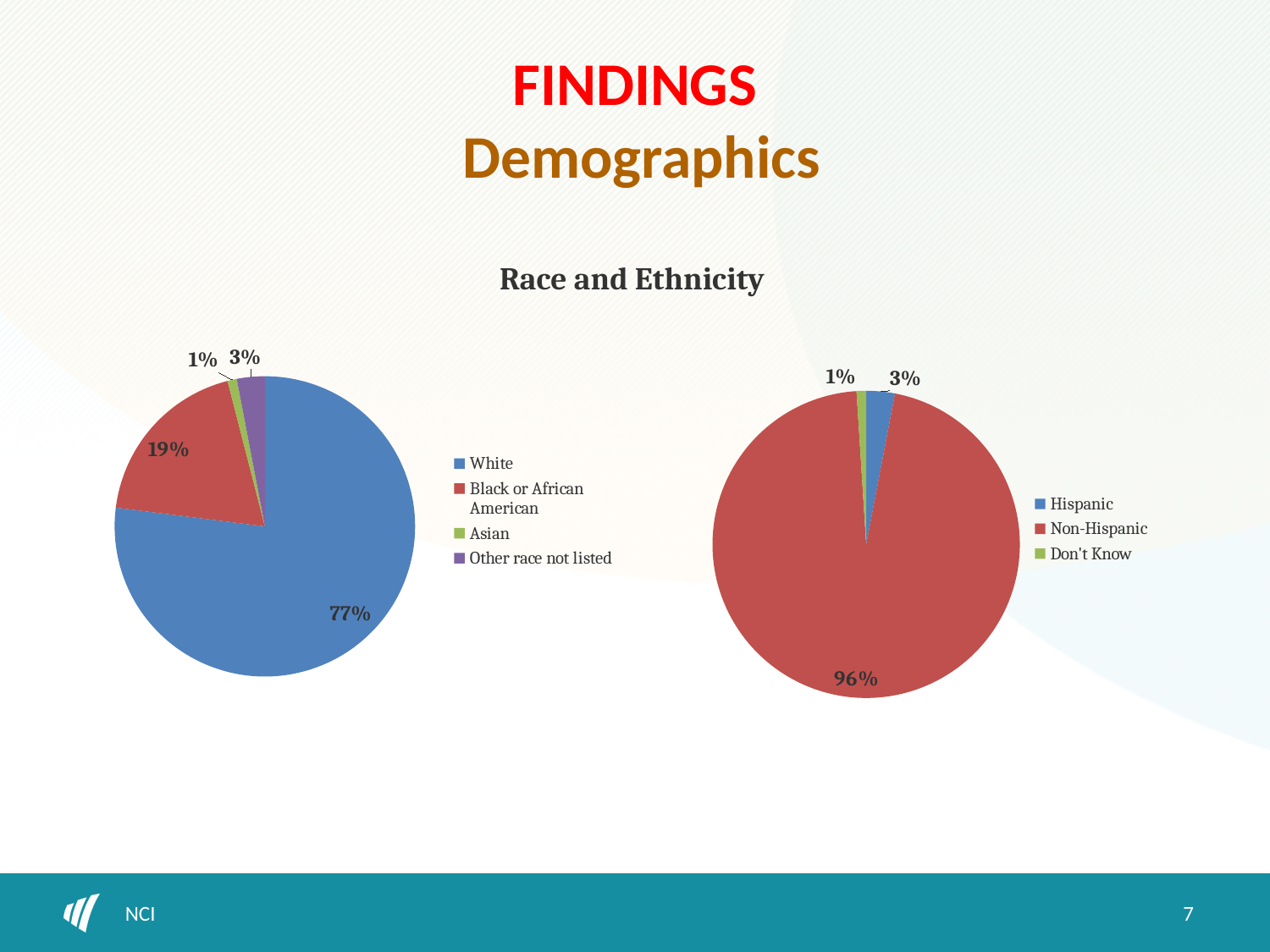
How many categories does the legend of the left pie chart list? 4 In the left pie chart, what share is Other race not listed? 3% In the left pie chart, which category has the smallest slice? Asian In the left pie chart, which category has the largest slice? White In the left pie chart, what share is White? 77% In the right pie chart, what share is Hispanic? 3% What type of chart is the right chart? Pie chart In the left pie chart, what is the difference between the White and Black or African American shares? 58% In the right pie chart, what share is Non-Hispanic? 96% In the right pie chart, which category has the smallest slice? Don't Know In the right pie chart, which is larger, Hispanic or Don't Know? Hispanic In the left pie chart, what share is Black or African American? 19%